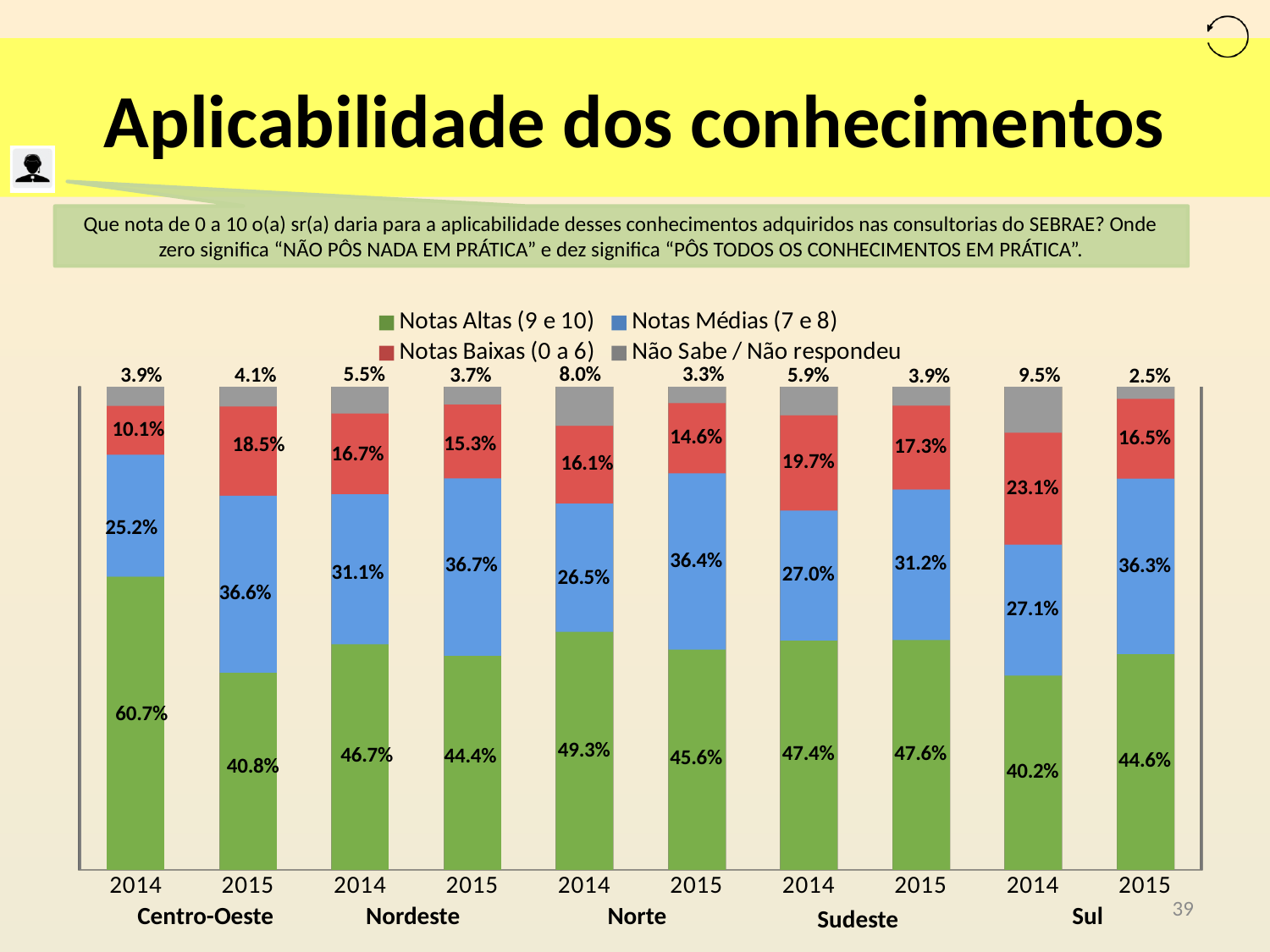
What is the difference between the Notas Altas (9 e 10) values for Centro-Oeste in 2014 and 2015? 19.9% What is the value of Notas Médias (7 e 8) for Sul in 2015? 36.3% What is the value of Notas Altas (9 e 10) for Centro-Oeste in 2014? 60.7% How many bars are plotted in the chart? 10 What kind of chart is shown on the slide? Stacked bar chart What is the value of Notas Baixas (0 a 6) for Sudeste in 2014? 19.7% How many series does the legend list? 4 Which bar has the highest value for Não Sabe / Não respondeu? Sul 2014 Which bar has the lowest value for Notas Altas (9 e 10)? Sul 2014 Which is larger: Notas Baixas (0 a 6) for Sul in 2014 or for Sul in 2015? Sul 2014 Which bar has the highest value for Notas Altas (9 e 10)? Centro-Oeste 2014 What is the value of Não Sabe / Não respondeu for Norte in 2014? 8.0%